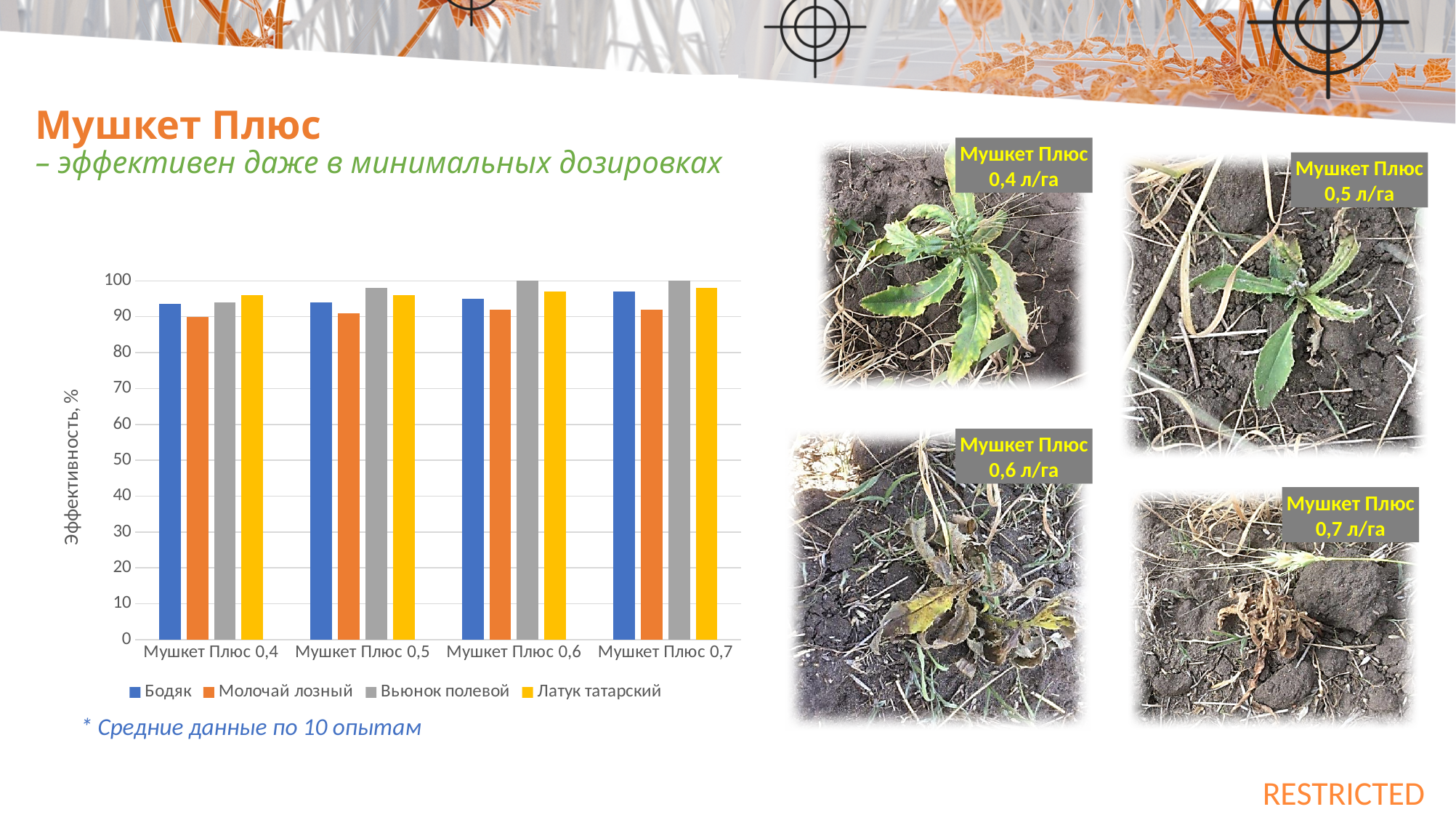
Which series has the lowest value at Мушкет Плюс 0,4? Молочай лозный Which colour represents Латук татарский in the chart legend? yellow Do the values for Бодяк rise or fall as the dosage increases from Мушкет Плюс 0,4 to Мушкет Плюс 0,7? rise How many series does the chart legend list? 4 Which series has the highest value at Мушкет Плюс 0,6? Вьюнок полевой At Мушкет Плюс 0,7, which is larger: the value for Бодяк or the value for Молочай лозный? Бодяк What kind of chart is shown on the slide? bar chart What is the value for Вьюнок полевой at Мушкет Плюс 0,6? 100 How many dosage categories are shown on the x axis of the chart? 4 Is the value for Молочай лозный at Мушкет Плюс 0,7 greater or less than 80? greater Is the value for Бодяк at Мушкет Плюс 0,4 greater or less than 90? greater What is the label of the vertical axis of the chart? Эффективность, %